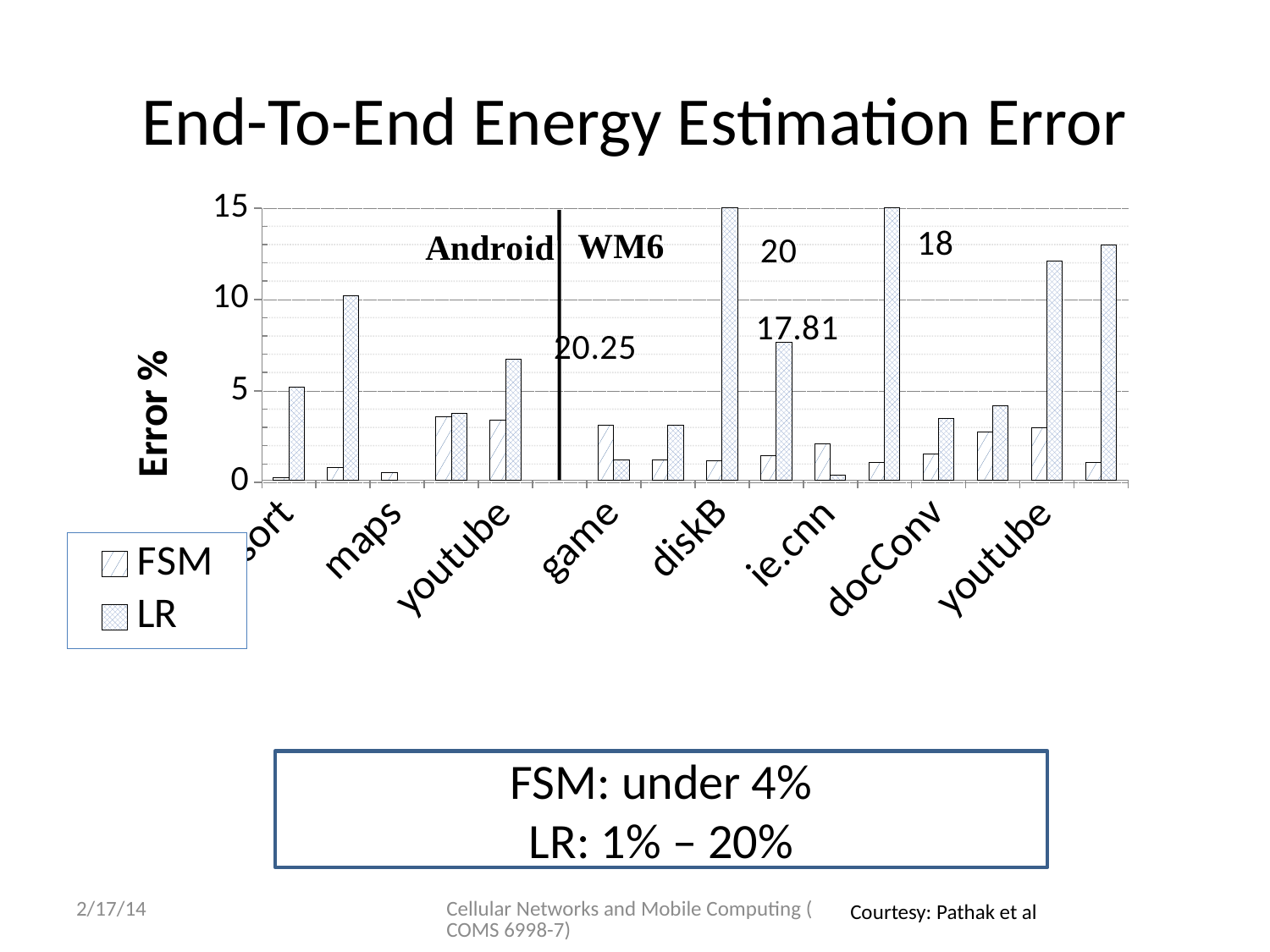
What are the two series named in the legend? FSM and LR For the WM6 youtube category, which series has the larger value, FSM or LR? LR Is the FSM value for game greater or less than 5? less What kind of chart is shown on the slide? bar chart What is the label on the y axis of the chart? Error % Is the LR value for game greater or less than 5? less Is the FSM value for docConv greater or less than 5? less How many series does the legend list? 2